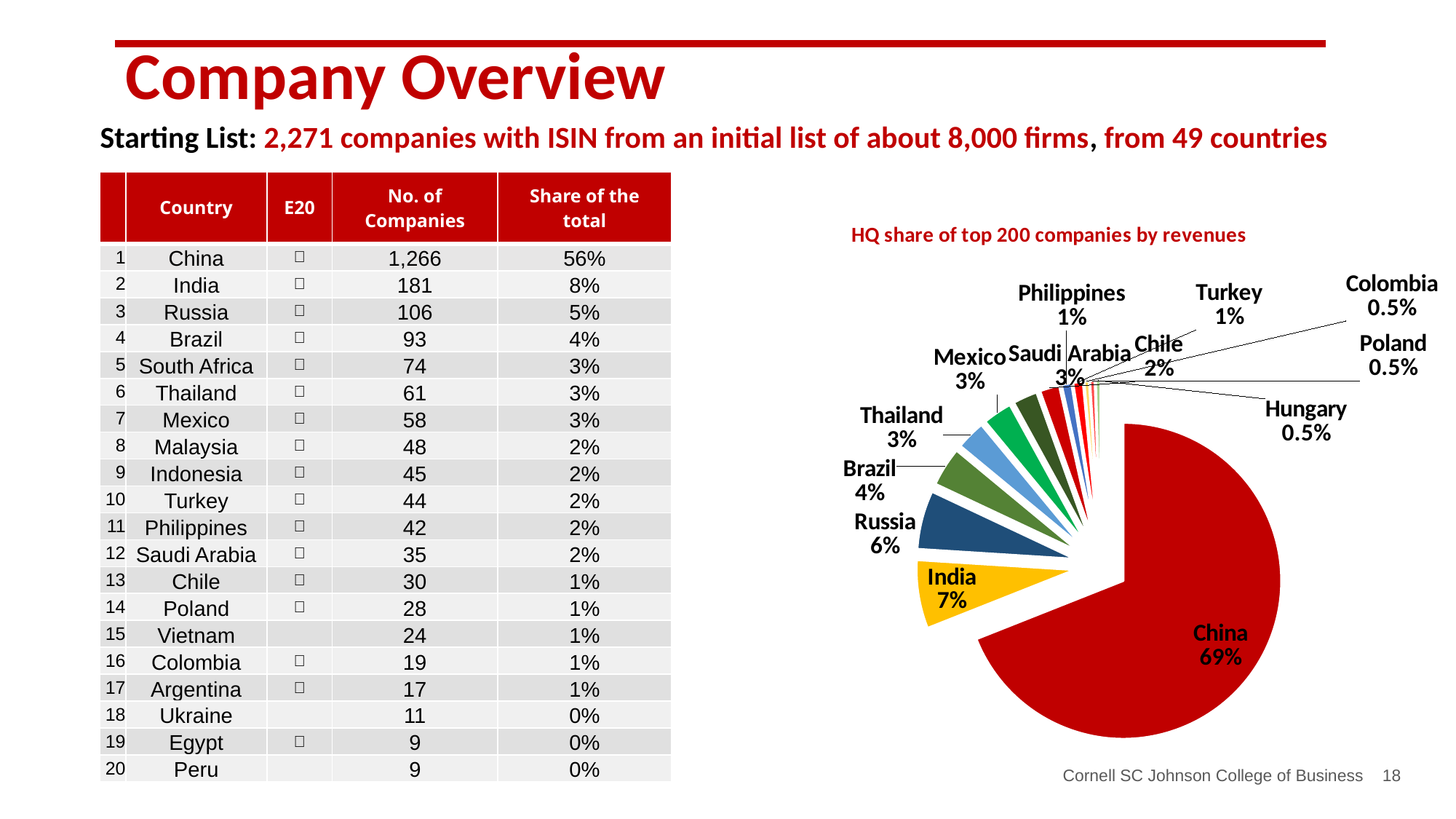
In the pie chart, what is the difference between Brazil's share and Chile's share? 2% In the pie chart, what share does Russia have? 6% In the pie chart, which is larger, the share for India or the share for Russia? India What kind of chart is shown on the slide? pie chart In the pie chart, what share does China have? 69% What is the title of the pie chart? HQ share of top 200 companies by revenues Which country has the largest slice in the pie chart? China In the pie chart, what share does India have? 7% In the pie chart, what is the difference between China's share and India's share? 62% In the pie chart, what share does Chile have? 2% In the pie chart, what share does Brazil have? 4% In the pie chart, what share does Hungary have? 0.5%